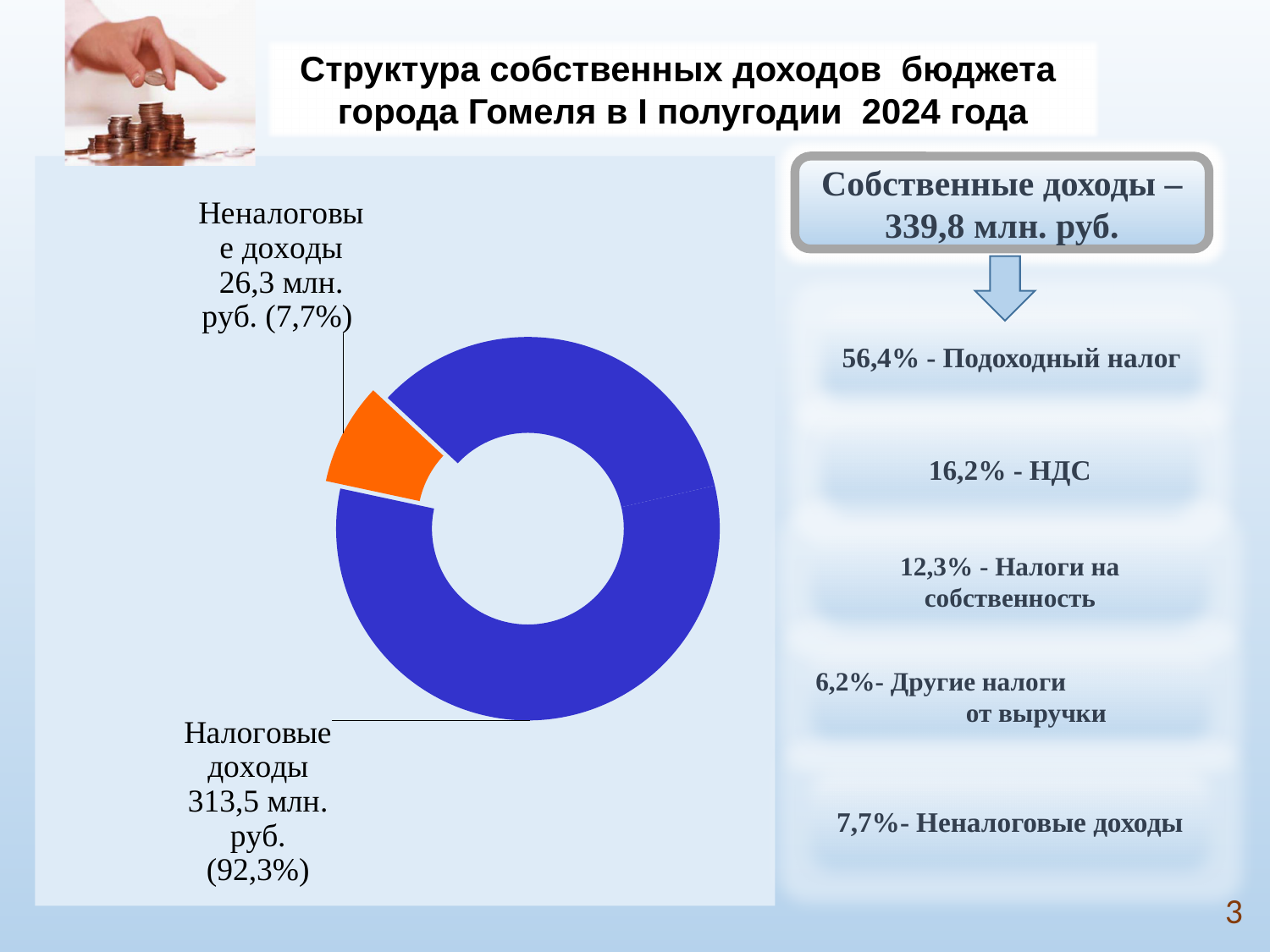
What kind of chart is shown on the slide? doughnut chart What share of the doughnut chart does Неналоговые доходы represent? 7,7% Which slice of the doughnut chart is the largest? Налоговые доходы What is the value for Неналоговые доходы in the doughnut chart? 26,3 млн. руб. How many slices does the doughnut chart have? 2 What is the difference in млн. руб. between Налоговые доходы and Неналоговые доходы in the doughnut chart? 287,2 млн. руб. What colour is the Неналоговые доходы slice in the doughnut chart? orange What is the total of the two slices in the doughnut chart, in млн. руб.? 339,8 млн. руб. What is the value for Налоговые доходы in the doughnut chart? 313,5 млн. руб. Which slice of the doughnut chart is the smallest? Неналоговые доходы What share of the doughnut chart does Налоговые доходы represent? 92,3% Which is larger in the doughnut chart: Налоговые доходы or Неналоговые доходы? Налоговые доходы